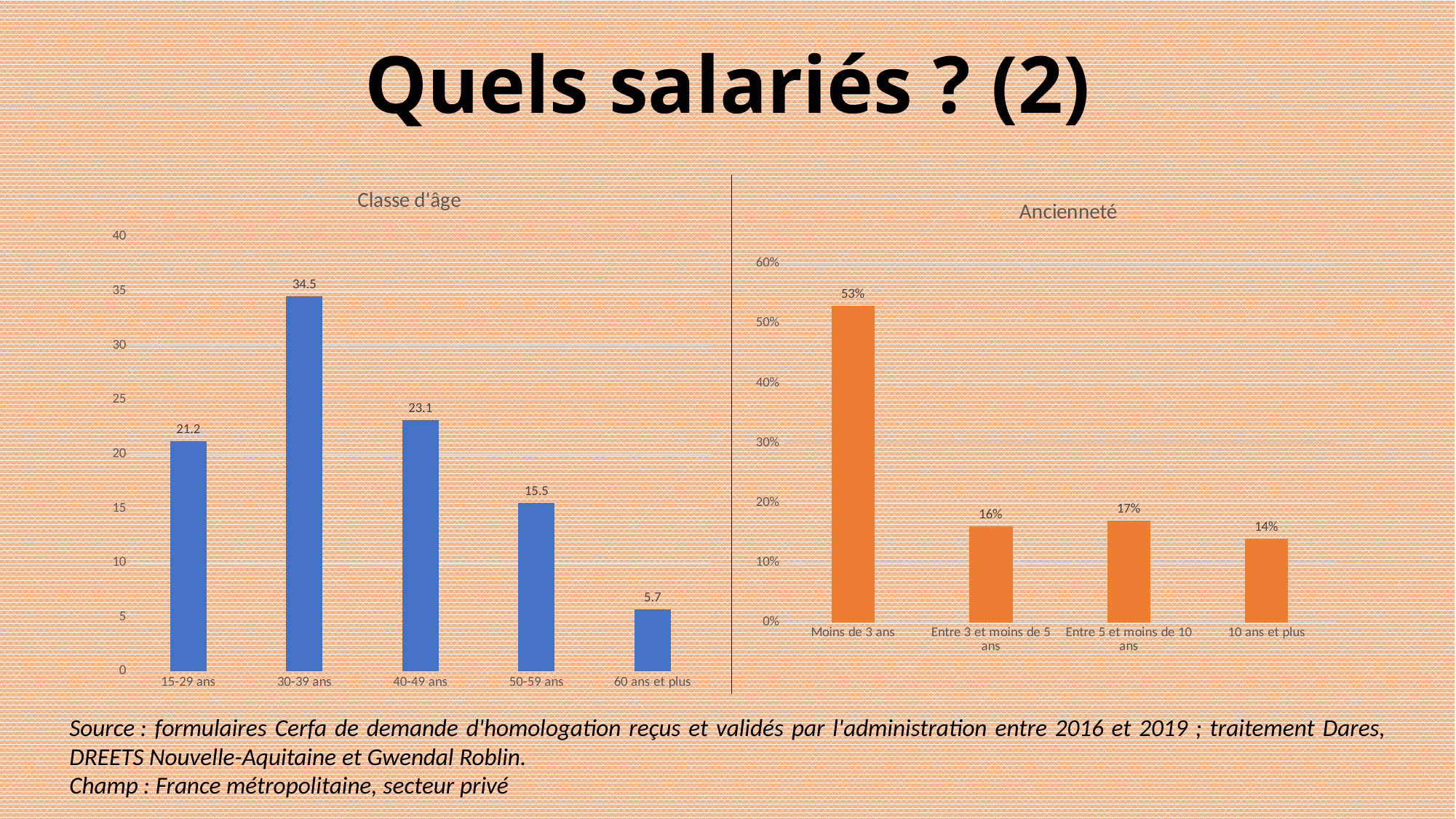
In the "Ancienneté" chart, which category has the highest value? Moins de 3 ans In the "Ancienneté" chart, what is the difference between the values for Moins de 3 ans and Entre 3 et moins de 5 ans? 37% In the "Ancienneté" chart, what is the value for 10 ans et plus? 14% In the "Classe d'âge" chart, what is the value for 30-39 ans? 34.5 What kind of chart is the "Ancienneté" chart? bar chart In the "Ancienneté" chart, is the value for Entre 5 et moins de 10 ans greater or less than 20%? less In the "Classe d'âge" chart, what is the difference between the values for 40-49 ans and 50-59 ans? 7.6 In the "Classe d'âge" chart, which age group has the highest value? 30-39 ans In the "Classe d'âge" chart, which age group has the lowest value? 60 ans et plus In the "Classe d'âge" chart, how many age groups are shown? 5 In the "Classe d'âge" chart, what is the value for 60 ans et plus? 5.7 In the "Ancienneté" chart, what is the value for Moins de 3 ans? 53%